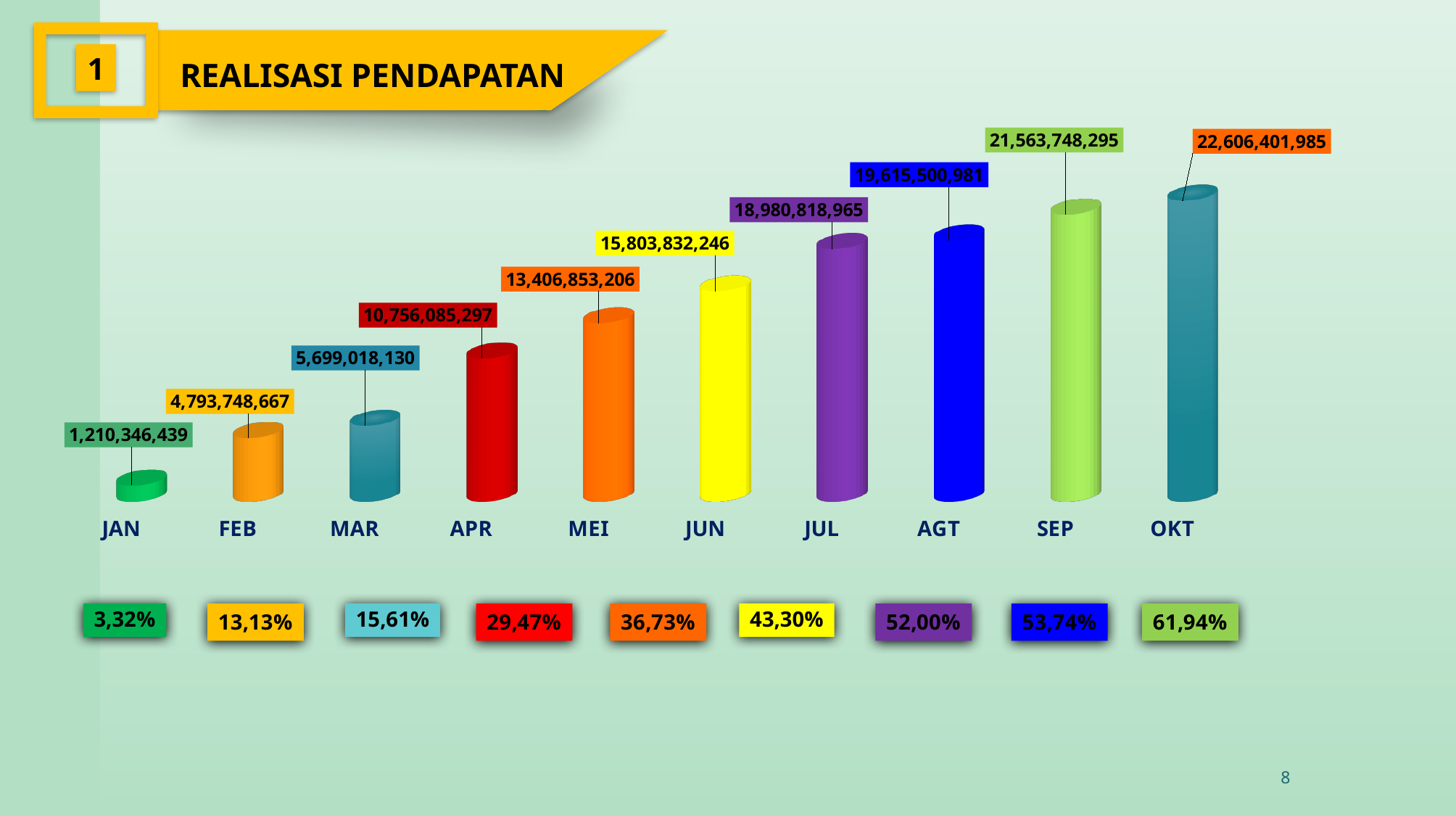
Do the values rise or fall from JAN to OKT? Rise What is the value for JAN? 1,210,346,439 What type of chart is shown on the slide? Bar chart What is the value for MEI? 13,406,853,206 What is the difference between the values for OKT and SEP? 1,042,653,690 Which month has the highest value? OKT Which is larger, the value for JUN or the value for JUL? JUL Which month has the lowest value? JAN What is the value for AGT? 19,615,500,981 What is the value for OKT? 22,606,401,985 What is the title of the chart? REALISASI PENDAPATAN How many months are shown on the x axis of the chart? 10